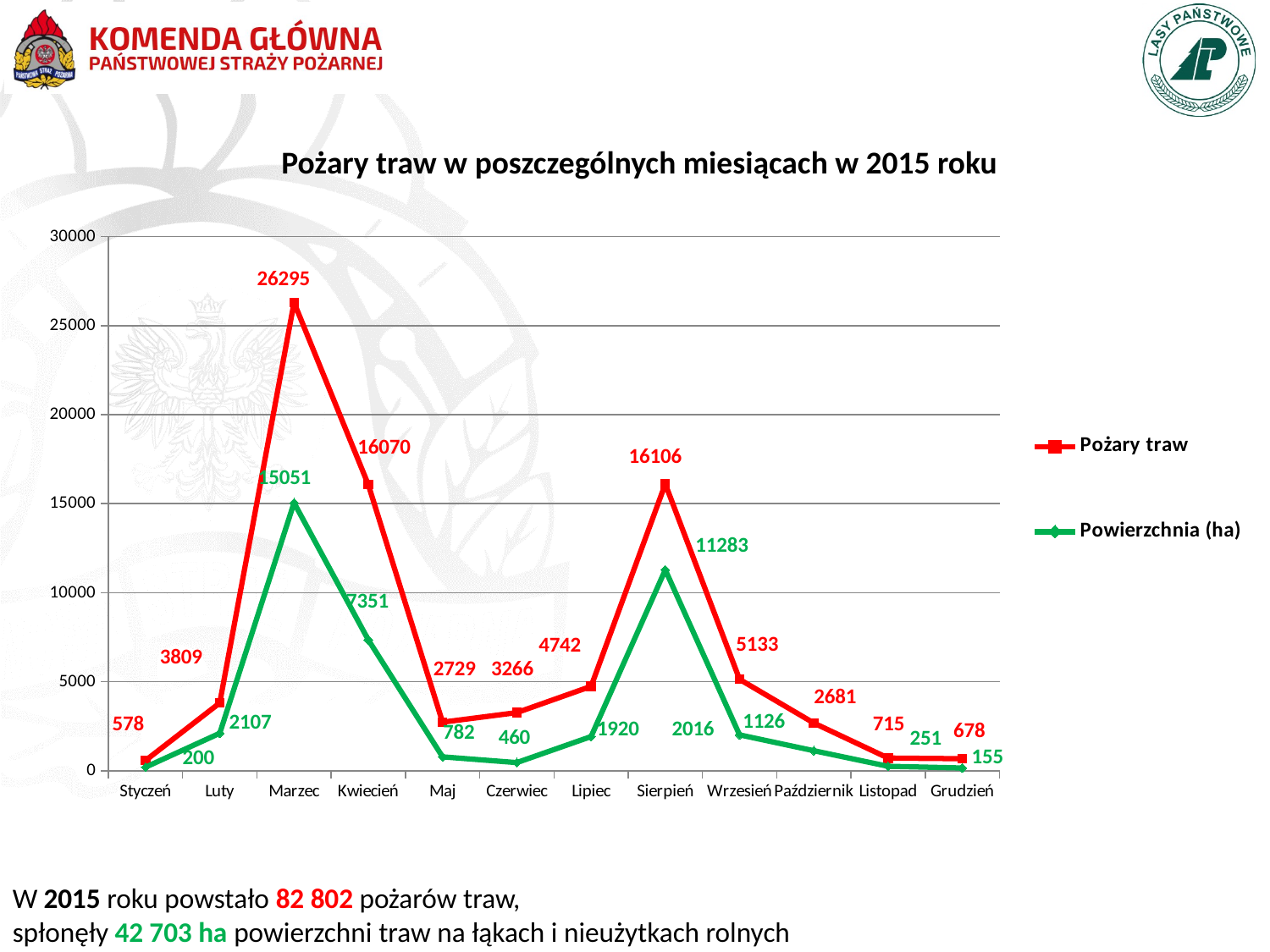
How many series does the chart legend list? 2 In which month is the Pożary traw series highest? Marzec Which month has the larger Pożary traw value, Luty or Czerwiec? Luty What is the burned area (Powierzchnia (ha)) for Sierpień? 11283 What is the difference between the Pożary traw values for Sierpień and Kwiecień? 36 What is the difference between the Powierzchnia (ha) values for Marzec and Kwiecień? 7700 How many months are shown on the x axis of the chart? 12 From Sierpień to Grudzień, does the Pożary traw series rise or fall? fall What is the Pożary traw value for Listopad? 715 In which month is the Powierzchnia (ha) series lowest? Grudzień What type of chart is shown on the slide? line chart How many grass fires (Pożary traw) were recorded in Marzec? 26295